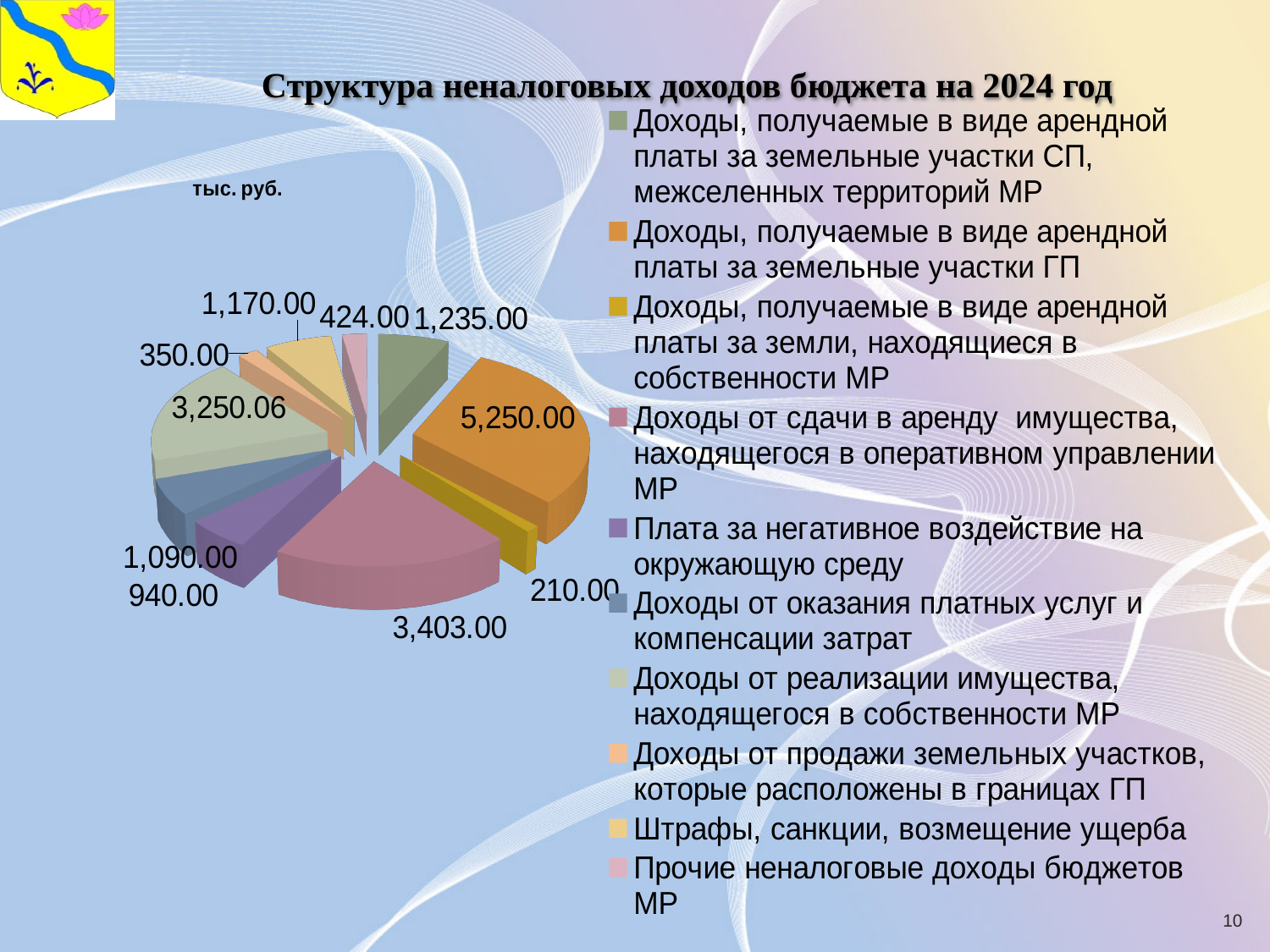
What is the value for 'Доходы от реализации имущества, находящегося в собственности МР'? 3,250.06 How many slices does the pie chart have? 10 How many entries does the legend list? 10 What is the title of the chart? Структура неналоговых доходов бюджета на 2024 год What is the difference between the value for 'Доходы, получаемые в виде арендной платы за земельные участки ГП' and the value for 'Доходы от сдачи в аренду имущества, находящегося в оперативном управлении МР'? 1,847.00 Which is larger: the value for 'Плата за негативное воздействие на окружающую среду' or the value for 'Доходы от оказания платных услуг и компенсации затрат'? Доходы от оказания платных услуг и компенсации затрат Which category has the smallest slice of the pie? Доходы, получаемые в виде арендной платы за земли, находящиеся в собственности МР What is the value for 'Доходы от сдачи в аренду имущества, находящегося в оперативном управлении МР'? 3,403.00 Which category has the largest slice of the pie? Доходы, получаемые в виде арендной платы за земельные участки ГП What is the value for 'Доходы, получаемые в виде арендной платы за земельные участки ГП'? 5,250.00 What is the value for 'Штрафы, санкции, возмещение ущерба'? 1,170.00 What kind of chart is shown on the slide? Pie chart